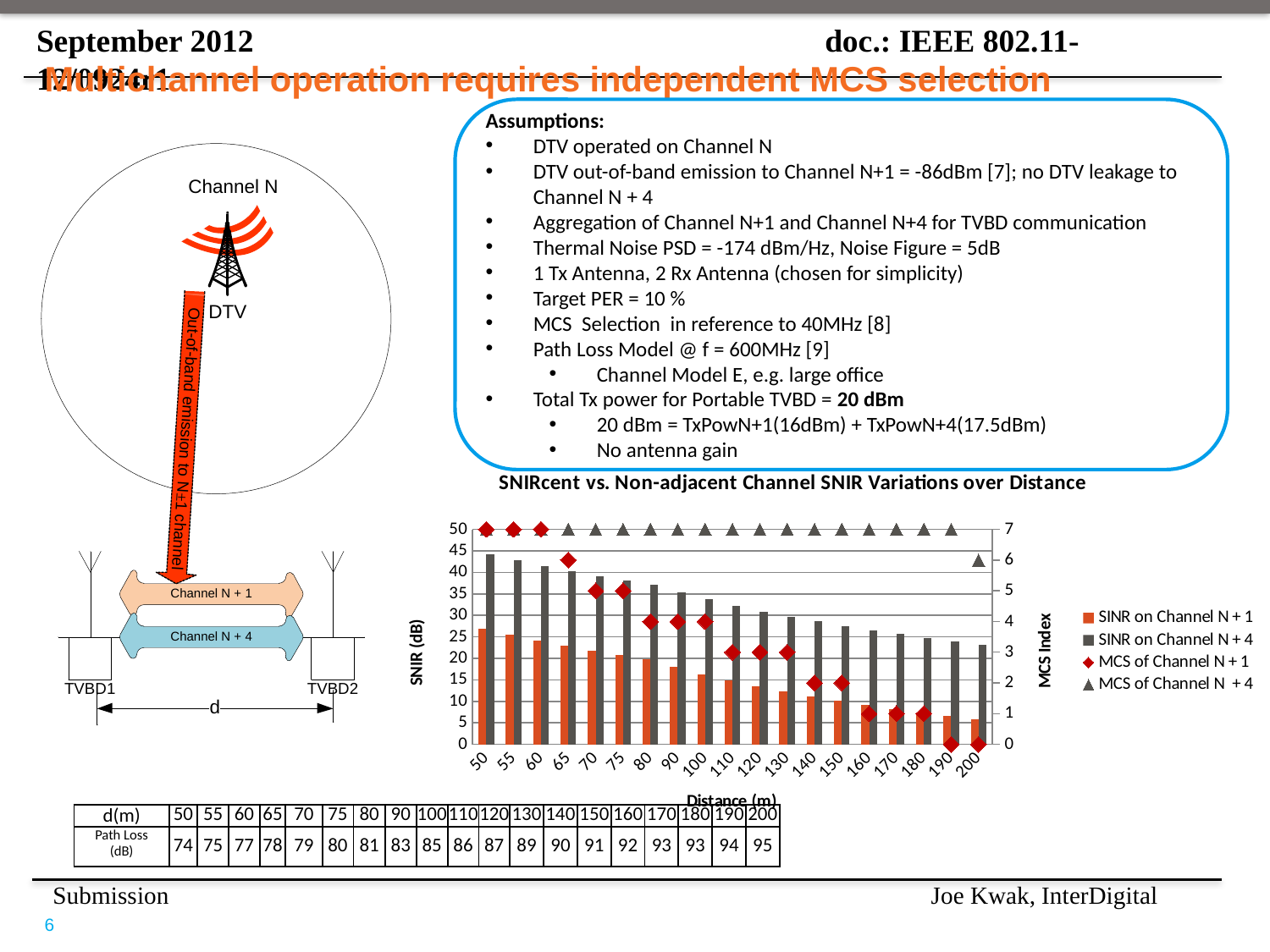
What is the MCS of Channel N + 1 at a distance of 110 m? 3 How many distance categories are plotted along the x axis of the chart? 19 How many series does the chart legend list? 4 What is the MCS of Channel N + 1 at a distance of 200 m? 0 What is the MCS of Channel N + 4 at a distance of 200 m? 6 What is the MCS of Channel N + 4 at a distance of 100 m? 7 Is the SINR on Channel N + 4 at 50 m greater or less than 40 dB? greater What is the title of the chart on the slide? SNIRcent vs. Non-adjacent Channel SNIR Variations over Distance Do the SINR values rise or fall as distance increases along the x axis? fall At 50 m, which is larger: SINR on Channel N + 1 or SINR on Channel N + 4? SINR on Channel N + 4 Is the SINR on Channel N + 1 at 200 m greater or less than 10 dB? less What is the MCS of Channel N + 1 at a distance of 70 m? 5